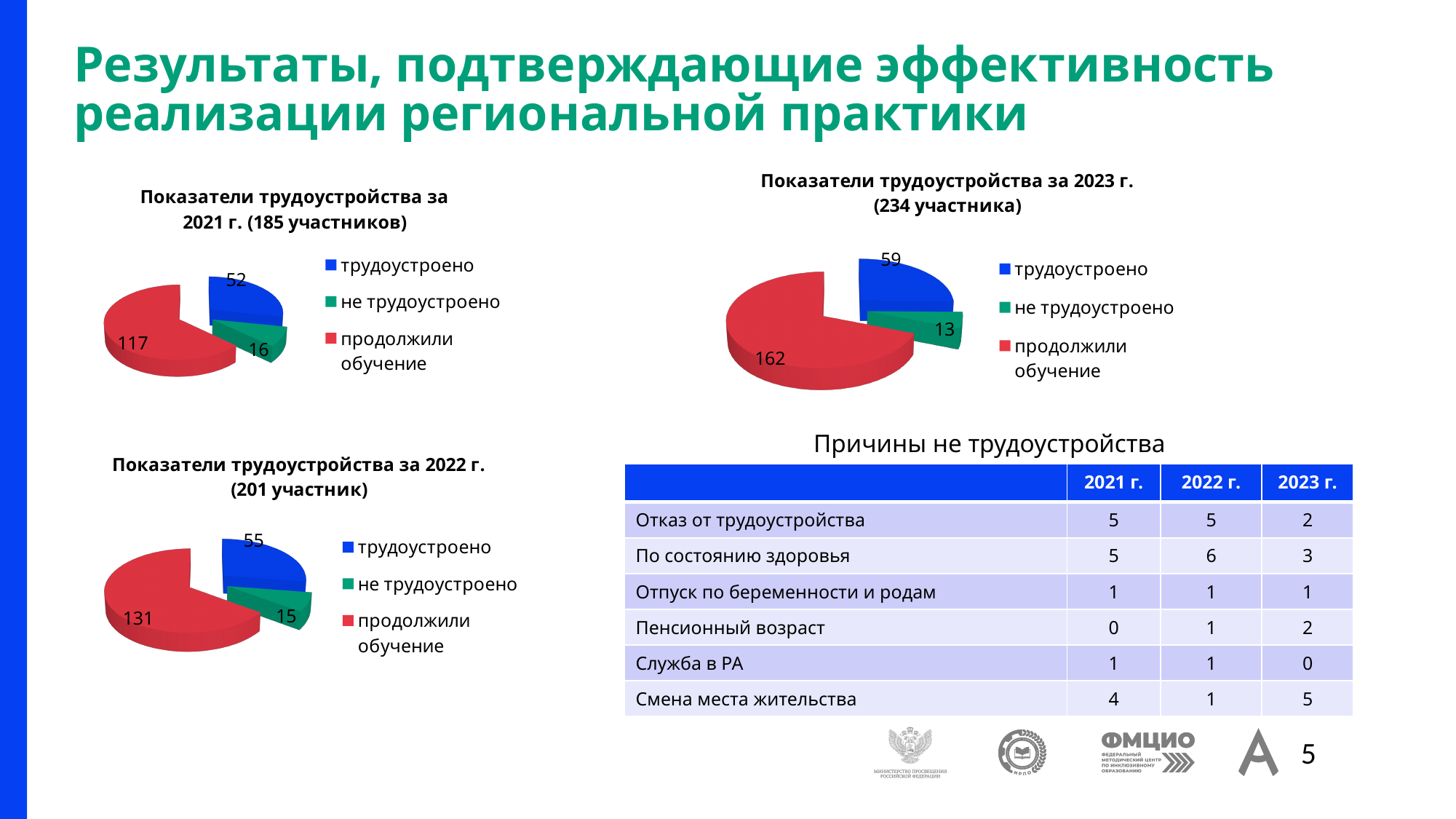
In the chart 'Показатели трудоустройства за 2021 г. (185 участников)', what is the value for 'трудоустроено'? 52 In the chart 'Показатели трудоустройства за 2021 г. (185 участников)', which category has the smallest slice? не трудоустроено In the chart 'Показатели трудоустройства за 2023 г. (234 участника)', what is the value for 'продолжили обучение'? 162 In the chart 'Показатели трудоустройства за 2021 г. (185 участников)', what colour is the slice for 'продолжили обучение'? red Which is larger: 'трудоустроено' in the 2021 chart or 'трудоустроено' in the 2023 chart? 2023 chart In the chart 'Показатели трудоустройства за 2022 г. (201 участник)', what is the difference between 'продолжили обучение' and 'трудоустроено'? 76 In the chart 'Показатели трудоустройства за 2023 г. (234 участника)', what share of the total does 'не трудоустроено' represent? 5.6% In the chart 'Показатели трудоустройства за 2023 г. (234 участника)', which category has the largest slice? продолжили обучение In the chart 'Показатели трудоустройства за 2023 г. (234 участника)', what is the difference between 'трудоустроено' and 'не трудоустроено'? 46 In the chart 'Показатели трудоустройства за 2022 г. (201 участник)', what is the value for 'не трудоустроено'? 15 What type of chart is 'Показатели трудоустройства за 2021 г. (185 участников)'? pie chart How many categories does the chart 'Показатели трудоустройства за 2022 г. (201 участник)' show? 3